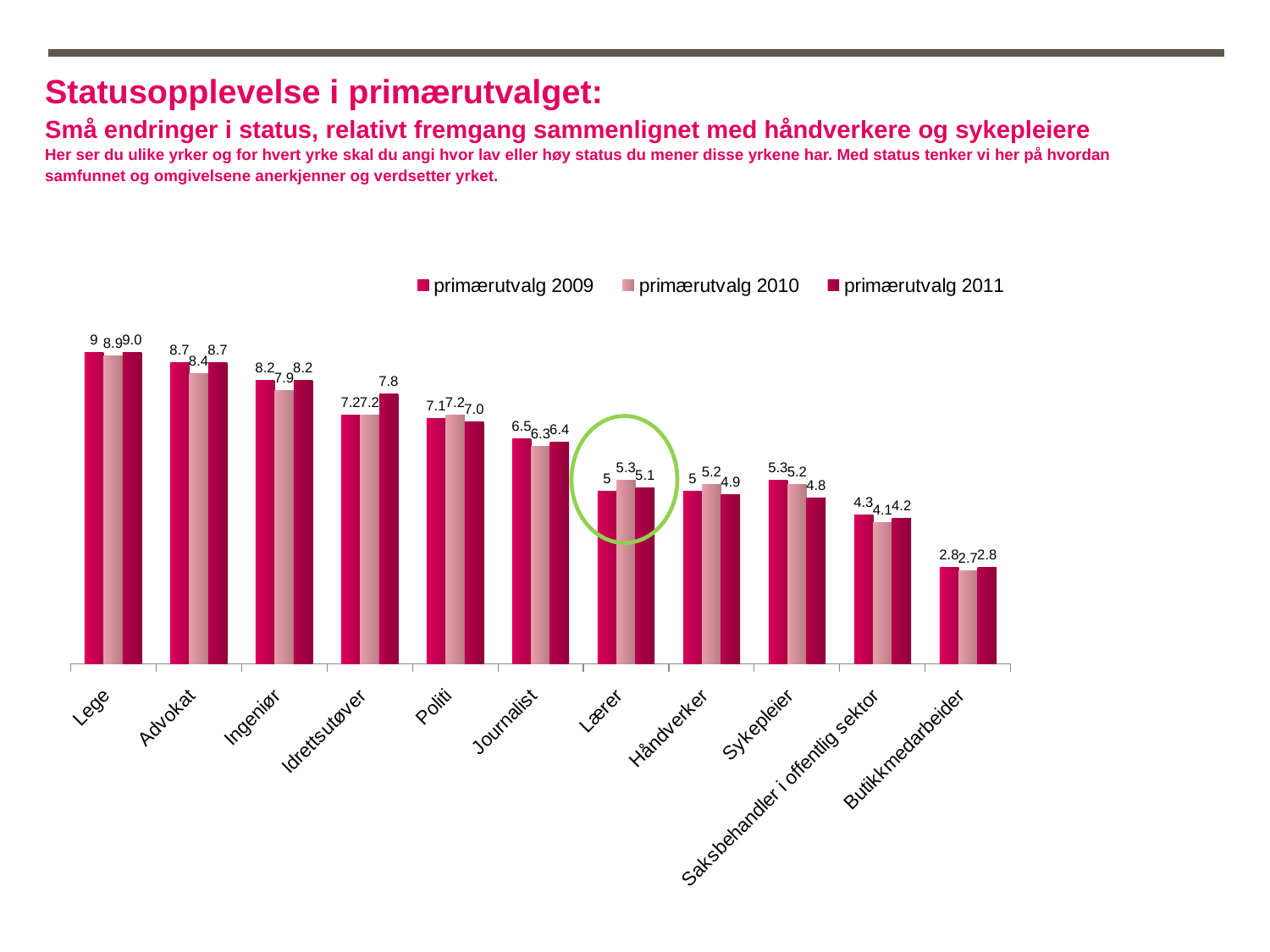
How many series does the legend list? 3 Which is larger for Sykepleier: the primærutvalg 2009 value or the primærutvalg 2011 value? primærutvalg 2009 Which occupation's group of bars is circled in green on the chart? Lærer What is the value for Idrettsutøver in the primærutvalg 2011 series? 7.8 What is the value for Lærer in the primærutvalg 2010 series? 5.3 Do the primærutvalg 2009 values generally rise or fall from left to right along the x axis? fall Which occupation has the lowest value in the primærutvalg 2010 series? Butikkmedarbeider What is the value for Sykepleier in the primærutvalg 2009 series? 5.3 What kind of chart is shown on the slide? bar chart Which occupation has the highest value in the primærutvalg 2011 series? Lege How many occupations (categories) are shown on the x axis? 11 What is the difference between the primærutvalg 2011 and primærutvalg 2009 values for Idrettsutøver? 0.6